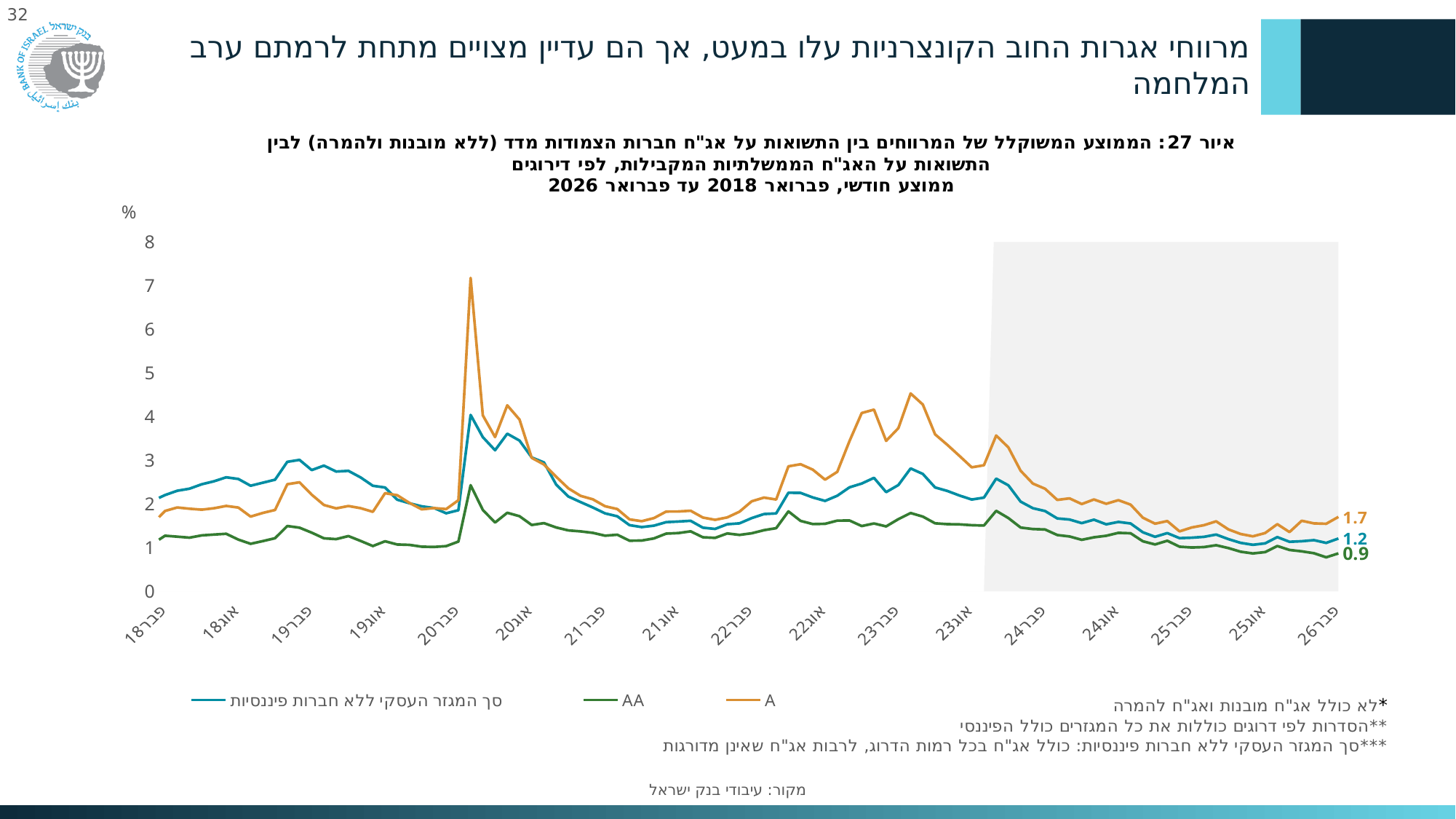
Is the value of the AA series in February 2018 greater or less than 2? less How many series does the legend list? 3 What kind of chart is shown on the slide? line chart At the end of the period, is the value of the A series larger or smaller than that of the AA series? larger What unit is shown on the y axis? % Which series has the lowest value at the end of the period (February 2026)? AA What is the difference between the final values of the A series and the AA series? 0.8 What is the final value (February 2026) of the series for the total business sector excluding financial companies (סך המגזר העסקי ללא חברות פיננסיות)? 1.2 Which series has the highest value at the end of the period (February 2026)? A What is the final value (February 2026) of the A series? 1.7 What is the final value (February 2026) of the AA series? 0.9 Is the peak value of the A series around spring 2020 greater or less than 6? greater